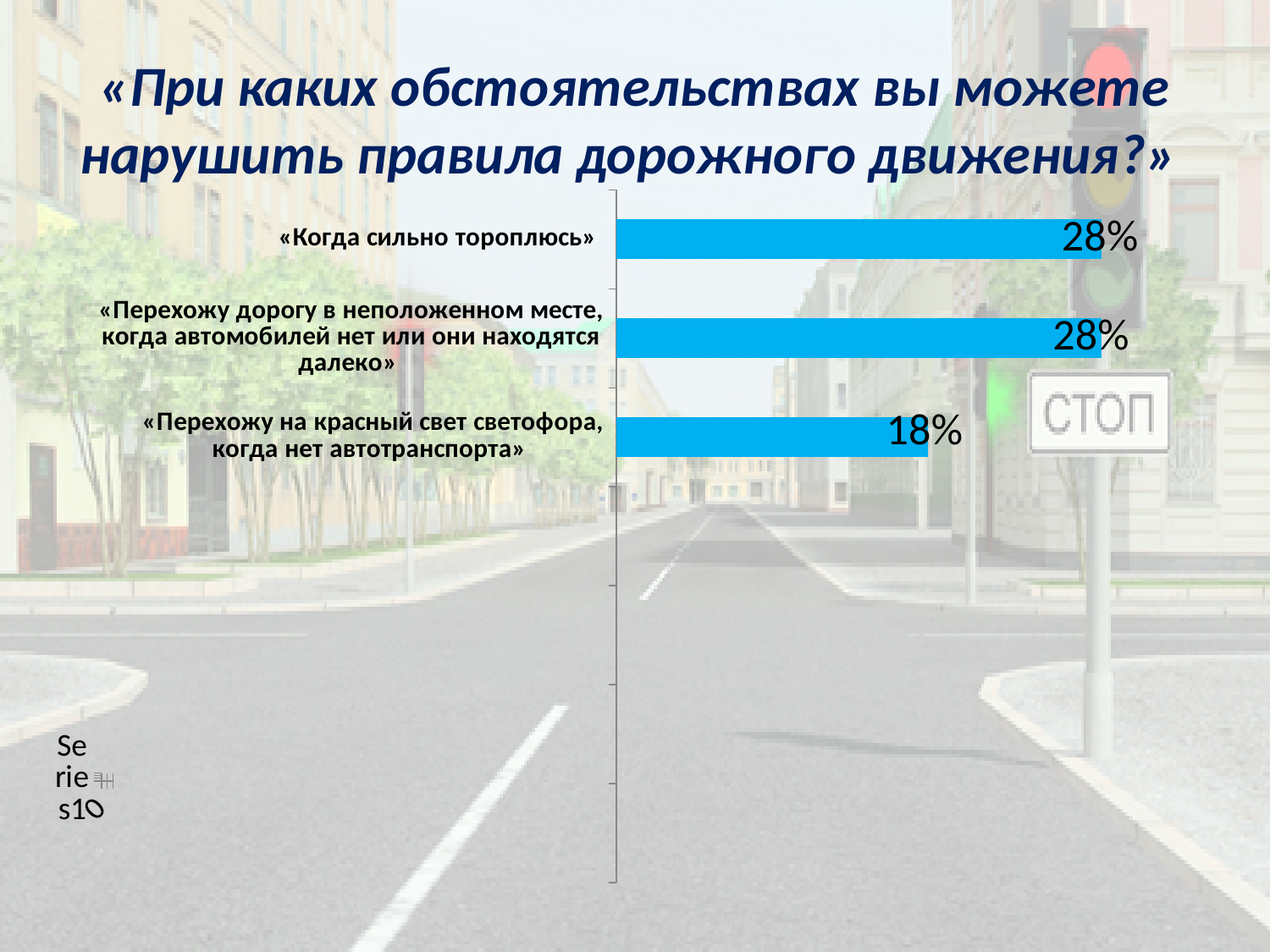
Which is larger: the value for «Перехожу дорогу в неположенном месте, когда автомобилей нет или они находятся далеко» or the value for «Перехожу на красный свет светофора, когда нет автотранспорта»? «Перехожу дорогу в неположенном месте, когда автомобилей нет или они находятся далеко» What is the highest value shown in the chart? 28% Which category has the lowest value? «Перехожу на красный свет светофора, когда нет автотранспорта» What is the title of the slide? «При каких обстоятельствах вы можете нарушить правила дорожного движения?» What colour are the bars in the chart? Blue What is the value for «Перехожу дорогу в неположенном месте, когда автомобилей нет или они находятся далеко»? 28% How many categories are shown in the chart? 3 What kind of chart is shown on the slide? Bar chart What is the value for «Перехожу на красный свет светофора, когда нет автотранспорта»? 18% What is the difference between the value for «Когда сильно тороплюсь» and the value for «Перехожу на красный свет светофора, когда нет автотранспорта»? 10% What is the value for «Когда сильно тороплюсь»? 28%